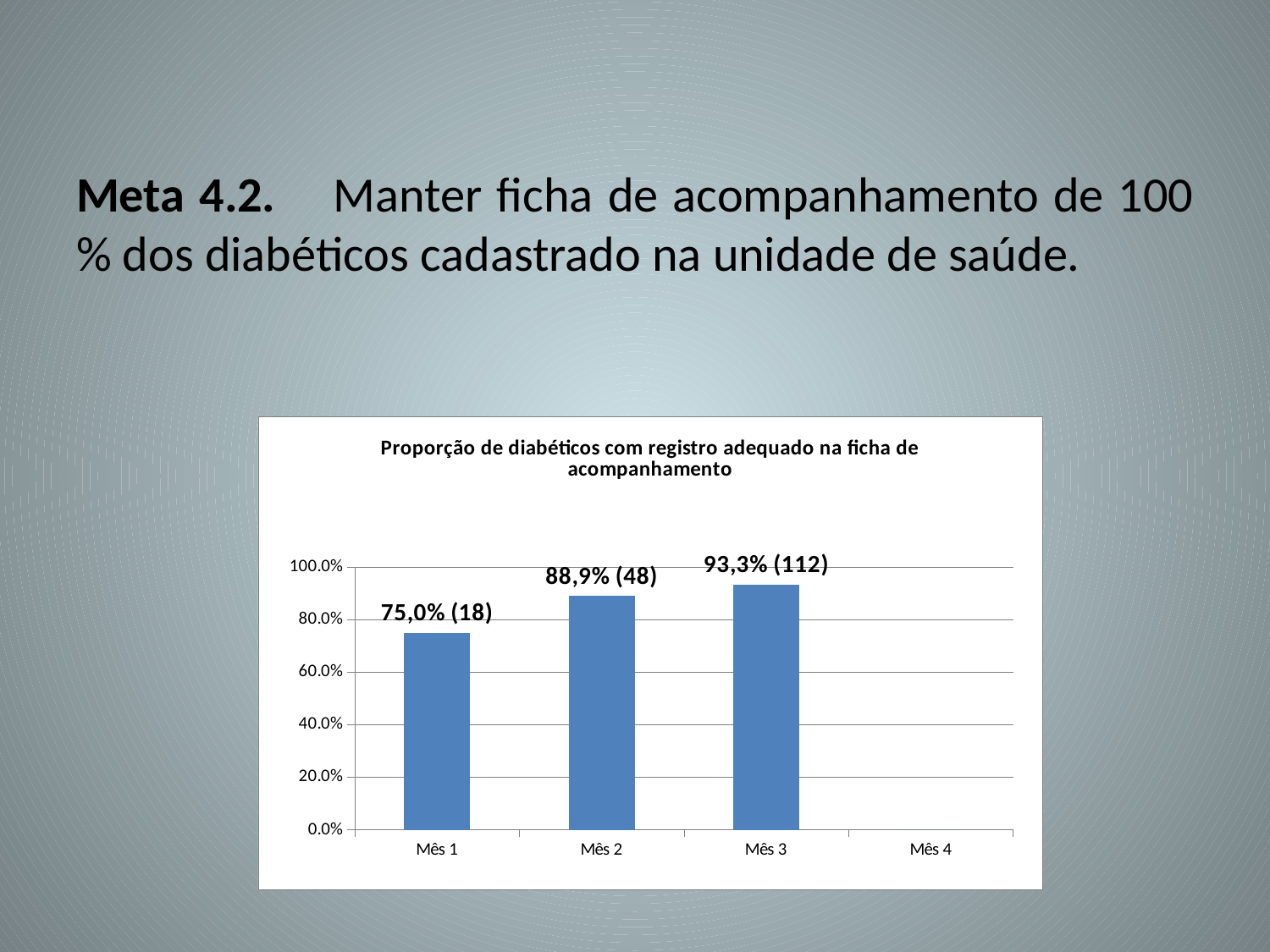
What is the data label shown for Mês 2? 88,9% (48) Is the value for Mês 1 greater or less than 80.0%? less What percentage is shown for Mês 3? 93,3% How many month categories are labelled on the x axis? 4 What is the title of the chart? Proporção de diabéticos com registro adequado na ficha de acompanhamento Which month category has no bar plotted? Mês 4 Which month has the highest proportion shown? Mês 3 Which is larger, the proportion for Mês 2 or for Mês 1? Mês 2 Among the months with a bar, which has the lowest proportion? Mês 1 Do the values rise or fall from Mês 1 to Mês 3? rise What type of chart is shown on the slide? bar chart What is the data label shown for Mês 1? 75,0% (18)